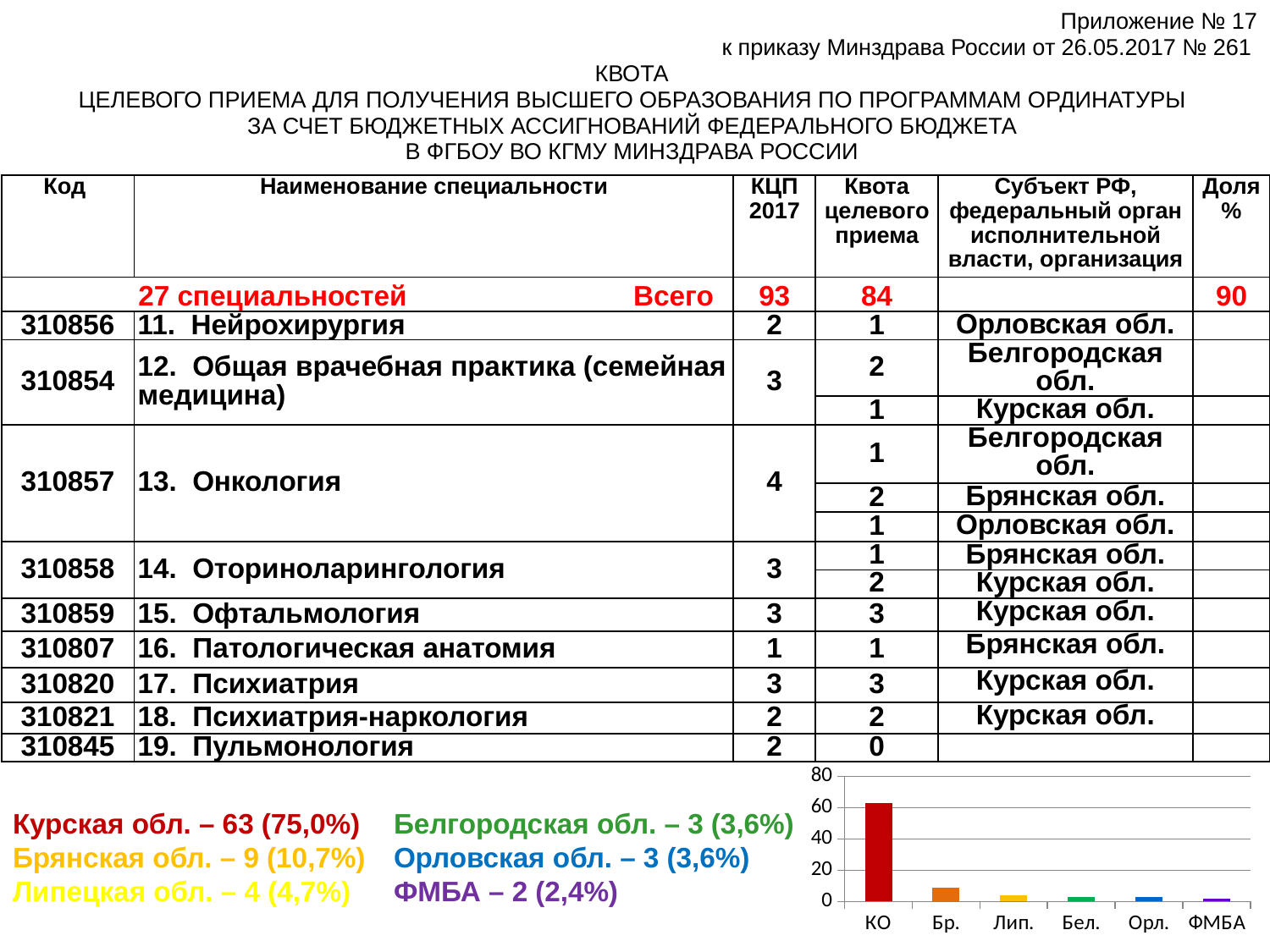
Which category has the highest bar in the chart? КО Do the bar values rise or fall moving from left to right along the x axis? fall Is the value for Бр. in the bar chart greater or less than 20? less Which is larger in the bar chart, the value for КО or the value for Бр.? КО Using the values printed beside the chart, what is the difference between Курская обл. (63) and Брянская обл. (9)? 54 What is the highest tick value shown on the y axis of the bar chart? 80 How many categories are shown on the x axis of the bar chart? 6 According to the text beside the chart, what is the value for Брянская обл.? 9 (10,7%) Is the value for КО in the bar chart greater or less than 40? greater According to the text beside the chart, what is the value for Курская обл.? 63 (75,0%) Is the value for Лип. in the bar chart greater or less than 20? less What kind of chart is shown at the bottom right of the slide? bar chart